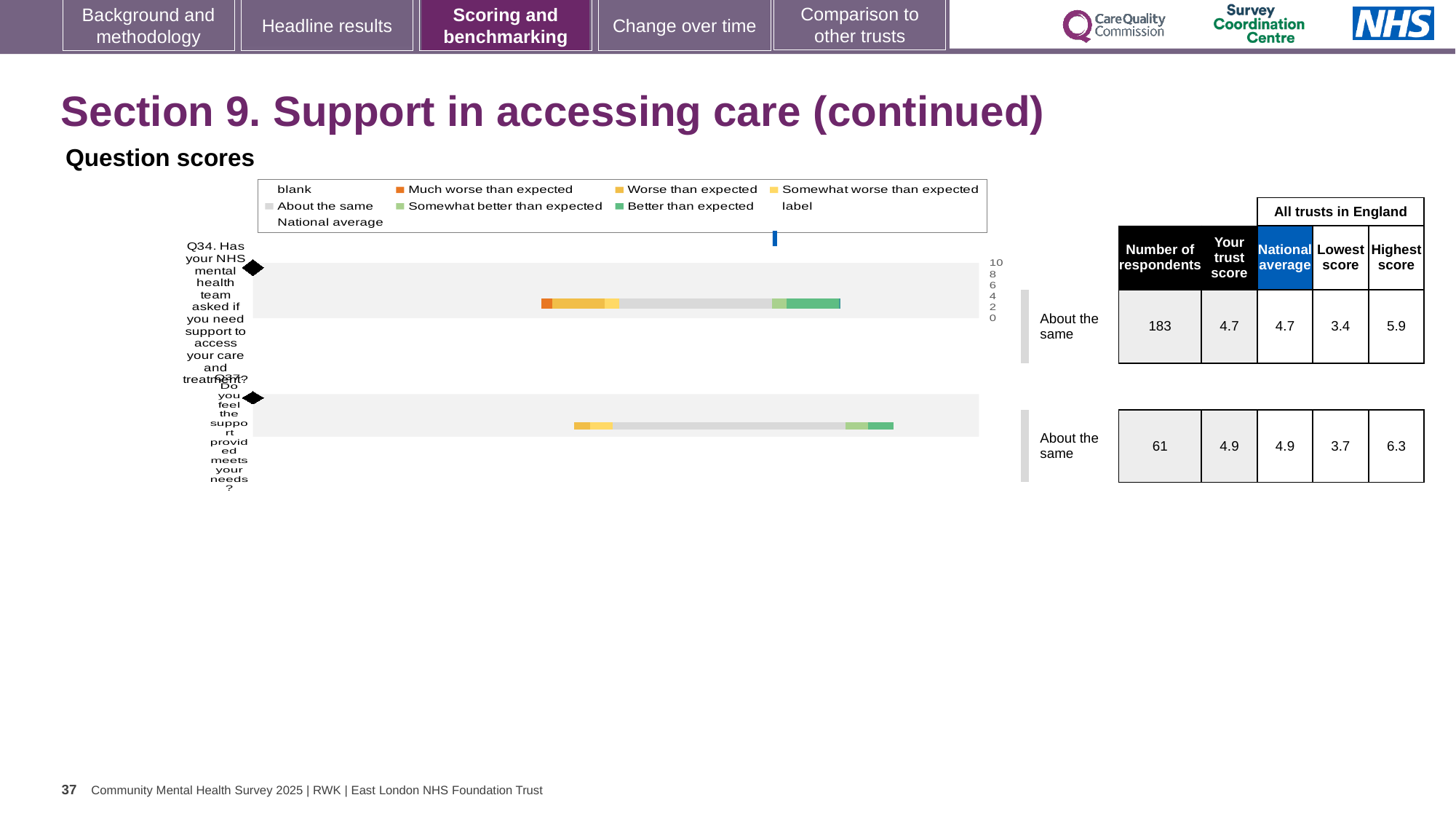
How many questions are plotted in the question scores chart? 2 What is the lowest score across all trusts in England for Q37? 3.7 What is the difference between the highest and lowest scores across all trusts in England for Q37? 2.6 What kind of chart is used to show the question scores? bar chart What is the national average score for Q37 (Do you feel the support provided meets your needs)? 4.9 What is the difference between the highest and lowest scores across all trusts in England for Q34? 2.5 How many respondents answered Q34? 183 Which question has the higher trust score, Q34 or Q37? Q37 What is the 'Your trust score' value for Q34 (Has your NHS mental health team asked if you need support to access your care and treatment)? 4.7 What is the highest score across all trusts in England for Q34? 5.9 Which question has more respondents, Q34 or Q37? Q34 What benchmark category is shown next to the bar for Q37? About the same